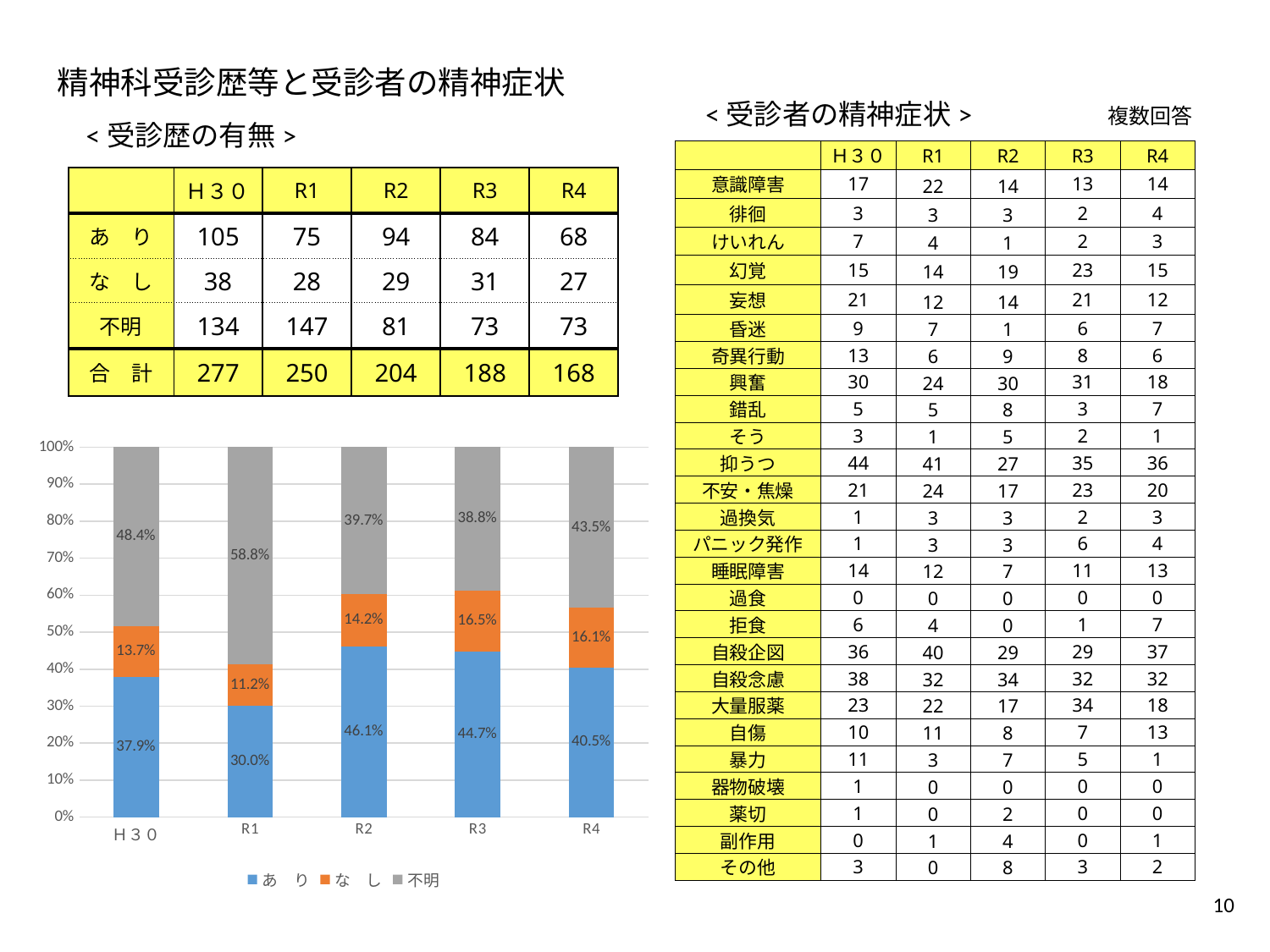
In the stacked bar chart, what is the value of あり for H30? 37.9% In the stacked bar chart, which year has the lowest value for なし? R1 How many years (categories) are shown on the x axis of the stacked bar chart? 5 In the stacked bar chart, which colour represents なし? orange In the stacked bar chart, what is the difference between the 不明 values for R1 and R2? 19.1% In the stacked bar chart, what is the value of 不明 for R1? 58.8% In the stacked bar chart, which year has the highest value for あり? R2 In the stacked bar chart, what is the value of 不明 for R4? 43.5% In the stacked bar chart, which is larger: あり for R3 or あり for R4? あり for R3 What kind of chart is shown on the slide? stacked bar chart How many series does the legend of the stacked bar chart list? 3 In the stacked bar chart, what is the value of なし for R3? 16.5%